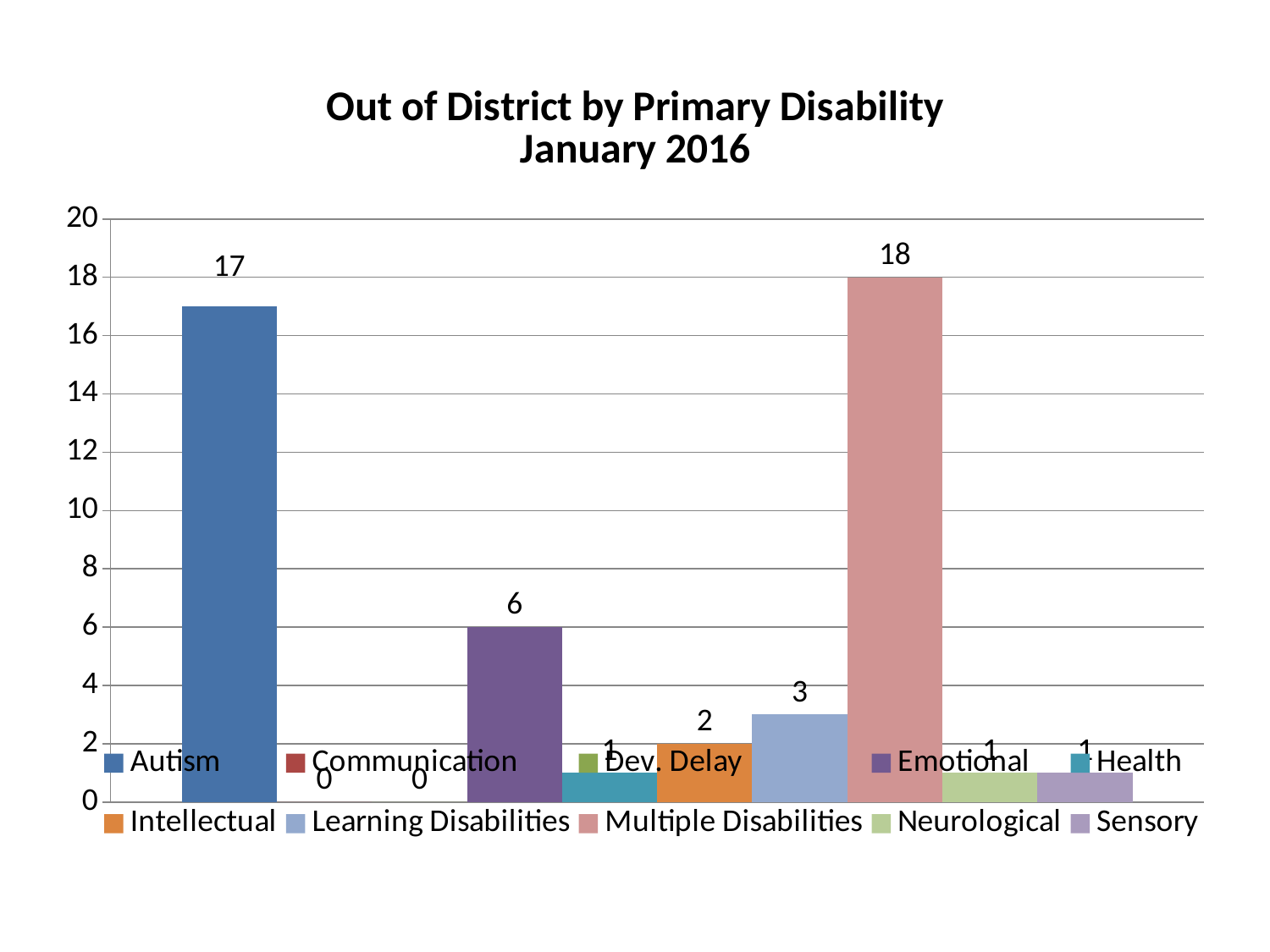
What is the difference between the values for Multiple Disabilities and Autism? 1 Which category has the highest value? Multiple Disabilities How many series does the legend list? 10 What is the title of the chart? Out of District by Primary Disability January 2016 What is the value for Multiple Disabilities? 18 Is the value for Autism greater or less than 10? greater What is the value for Learning Disabilities? 3 What kind of chart is shown on the slide? bar chart Which is larger, the value for Emotional or the value for Learning Disabilities? Emotional What is the value for Autism? 17 What is the value for Intellectual? 2 What is the value for Emotional? 6